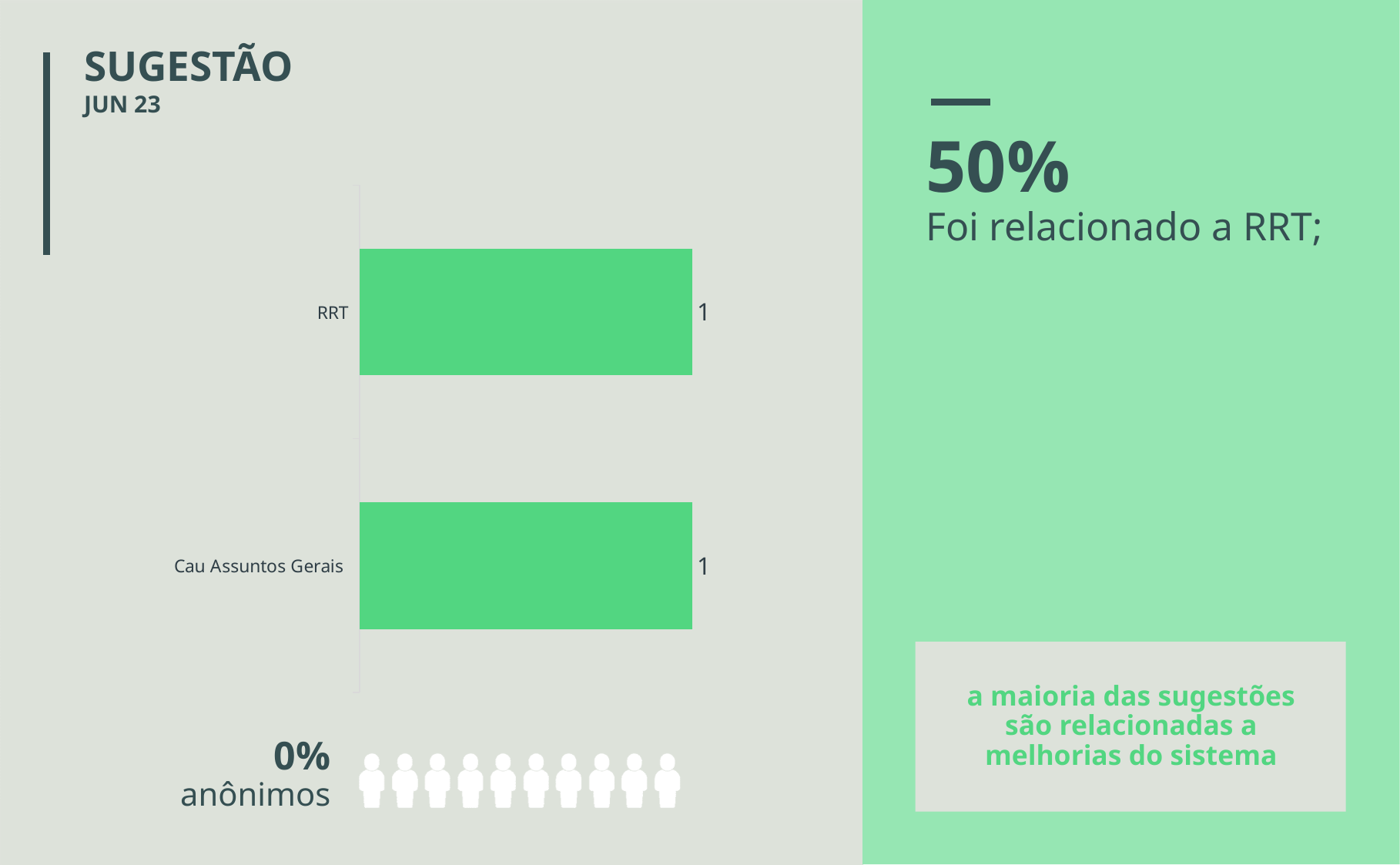
Do the values for RRT and Cau Assuntos Gerais differ? No, both are 1 What is the value for RRT? 1 What kind of chart is shown on the slide? bar chart What is the value for Cau Assuntos Gerais? 1 What is the total of the values for RRT and Cau Assuntos Gerais? 2 How many categories does the bar chart show? 2 Are the bars in the chart horizontal or vertical? horizontal What is the difference between the values for RRT and Cau Assuntos Gerais? 0 Which category is listed at the top of the bar chart? RRT What colour are the bars in the chart? green